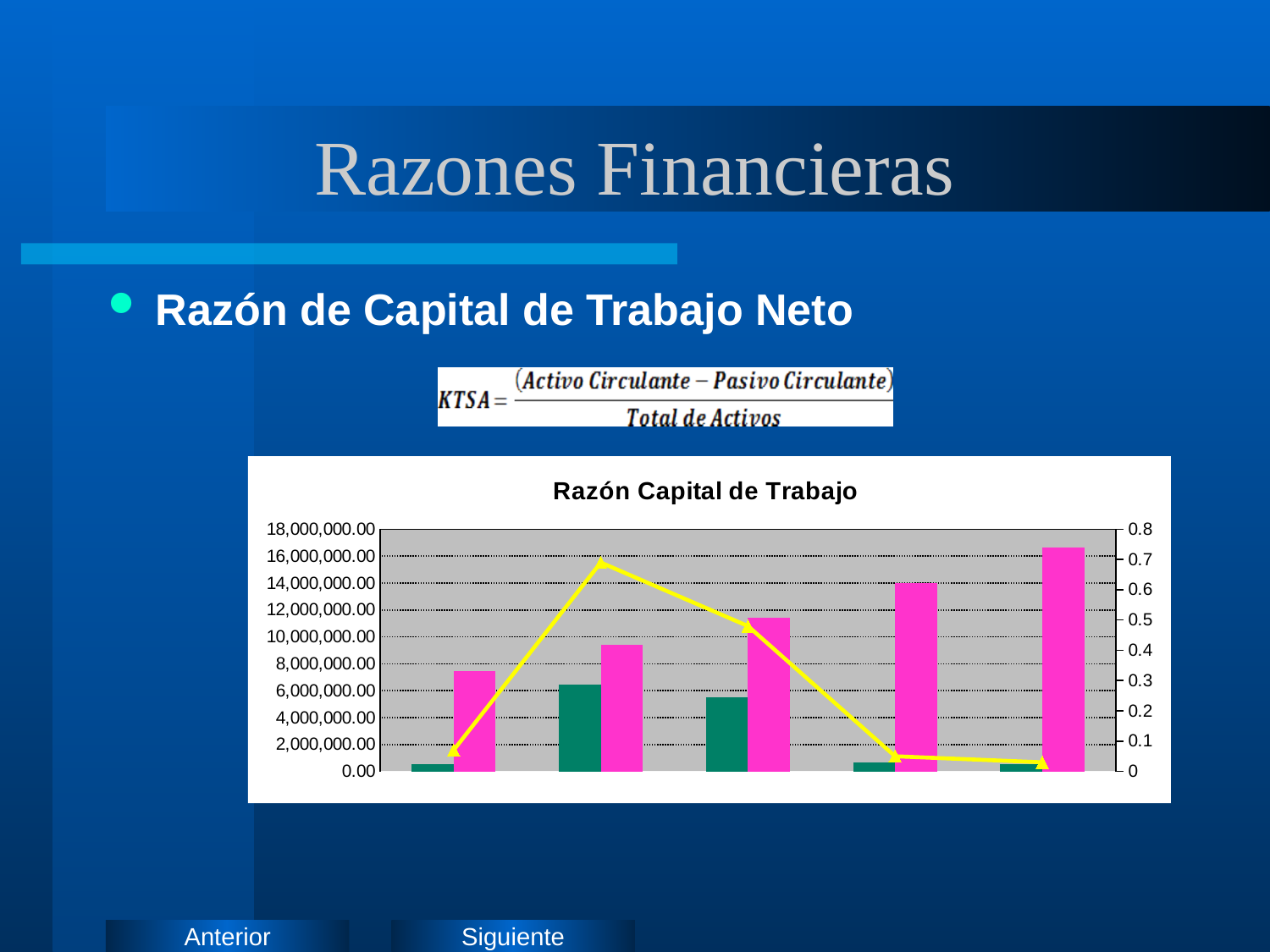
What is the highest value shown on the right vertical axis of the chart? 0.8 Is the green bar in the second group from the left greater or less than 6,000,000.00? greater Is the pink bar in the first group from the left greater or less than 8,000,000.00? less How many groups of bars are plotted in the chart? 5 What is the title of the chart on the slide? Razón Capital de Trabajo What kind of chart is shown on the slide? Bar chart with a line Is the tallest pink bar in the chart greater or less than 16,000,000.00? greater Which group of bars, counting from the left, has the tallest pink bar? The fifth (rightmost) group Does the yellow line rise or fall between its second and fourth points? Falls Which point of the yellow line, counting from the left, is the highest? The second point What is the highest value shown on the left vertical axis of the chart? 18,000,000.00